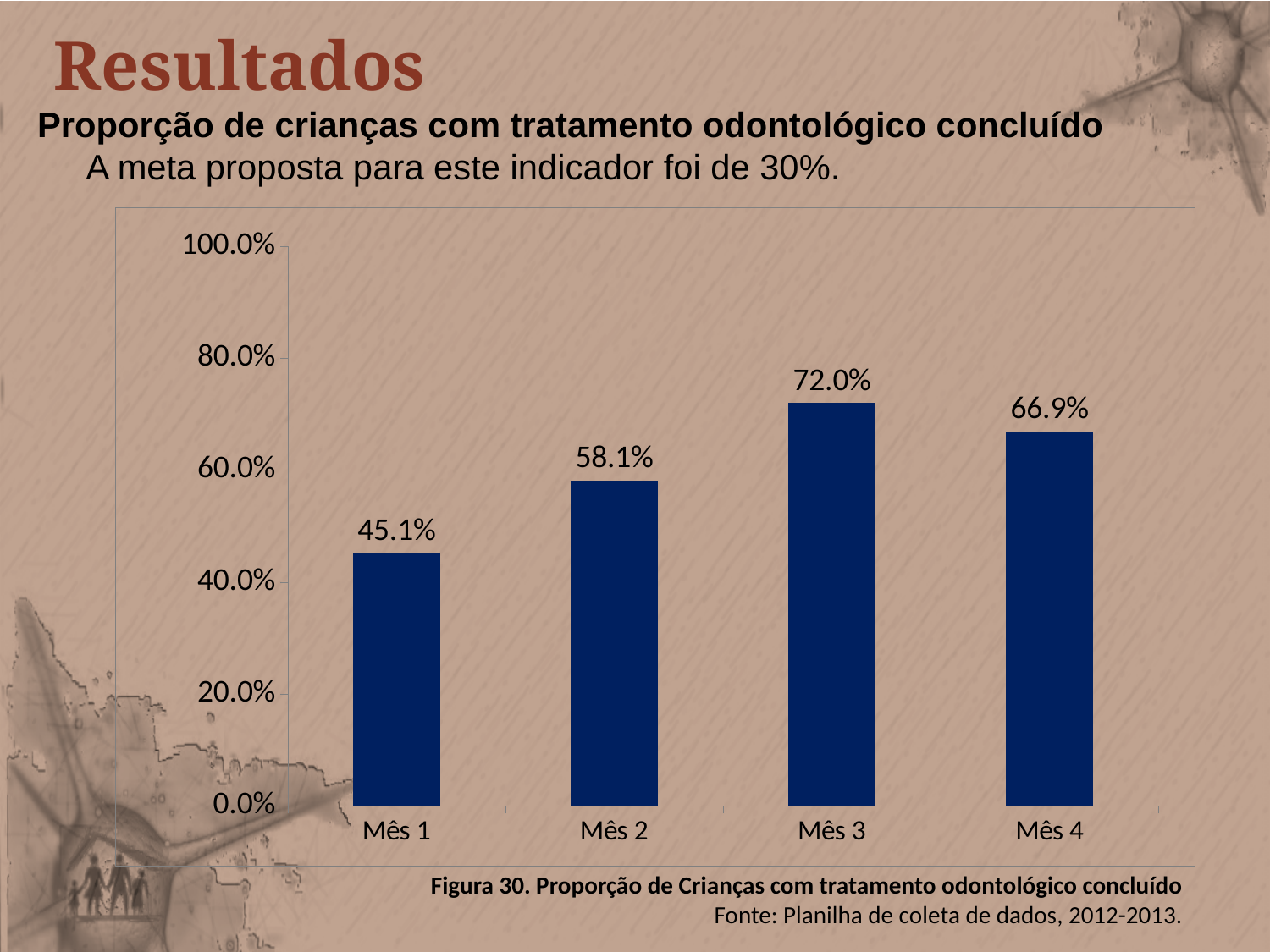
What is the value for Mês 4? 66.9% What is the value for Mês 3? 72.0% What kind of chart is shown on the slide? bar chart Is the value for Mês 2 greater or less than 60.0%? less What is the difference between the values for Mês 2 and Mês 1? 13.0% What is the difference between the values for Mês 3 and Mês 1? 26.9% What is the value for Mês 1? 45.1% Which month has the lowest value? Mês 1 Which month has the highest value? Mês 3 Which is larger, the value for Mês 2 or the value for Mês 4? Mês 4 How many months are shown on the x axis? 4 What is the figure caption below the chart? Figura 30. Proporção de Crianças com tratamento odontológico concluído